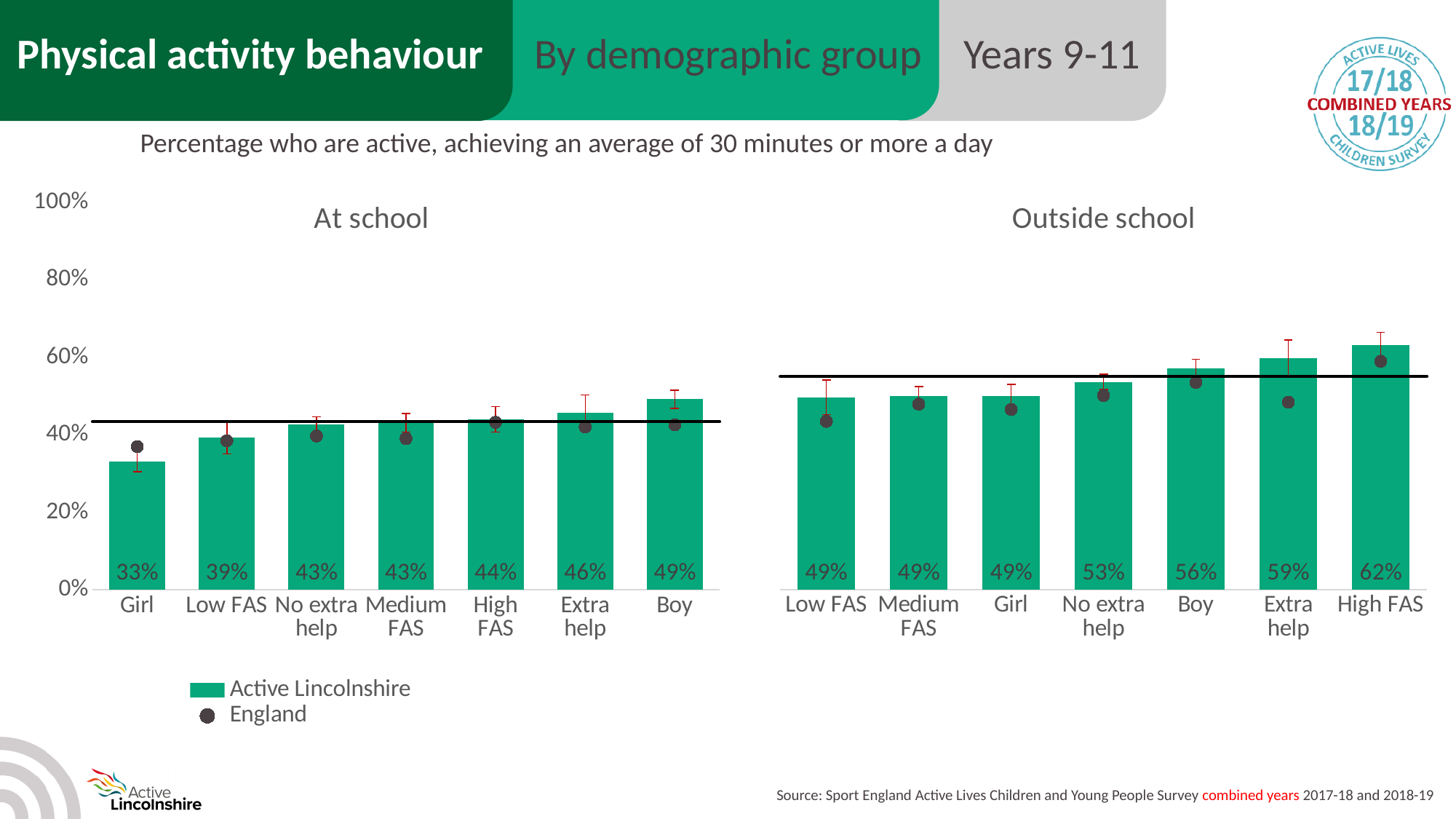
In the At school chart, what is the difference between the Active Lincolnshire values for Boy and Girl? 16% In the Outside school chart, what is the difference between the Active Lincolnshire values for High FAS and Low FAS? 13% In the At school chart, what is the Active Lincolnshire value for Girl? 33% How many categories are shown in the Outside school chart? 7 How many series does the legend list? 2 In the Outside school chart, which category has the highest Active Lincolnshire bar? High FAS In the At school chart, which category has the lowest Active Lincolnshire bar? Girl In the At school chart, is the England value for Girl greater or less than 40%? less In the At school chart, which category has the highest Active Lincolnshire bar? Boy What kind of chart is the At school chart? bar chart In the Outside school chart, what is the Active Lincolnshire value for High FAS? 62% In the Outside school chart, which is larger, the Active Lincolnshire value for Boy or for No extra help? Boy